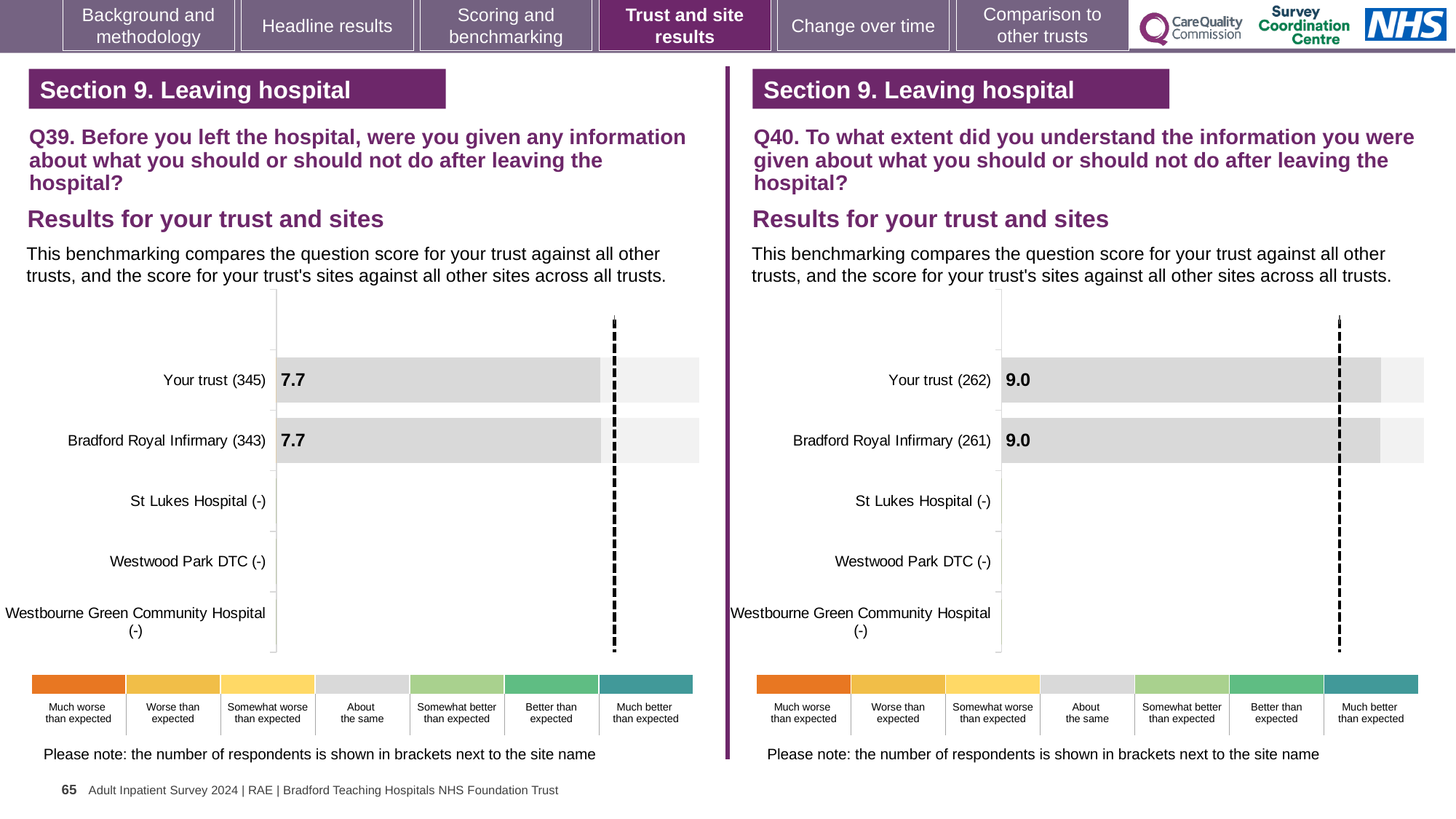
On the Q39 chart (left), what is the score for Your trust? 7.7 On the Q40 chart (right), how many categories have a plotted bar? 2 On the Q40 chart (right), what is the score for Bradford Royal Infirmary? 9.0 On the Q39 chart (left), what is the score for Bradford Royal Infirmary? 7.7 On the Q39 chart (left), how many site or trust categories are listed on the vertical axis? 5 On the Q39 chart (left), how many respondents are shown in brackets for Bradford Royal Infirmary? 343 On the Q40 chart (right), how many respondents are shown in brackets for Your trust? 262 On the Q40 chart (right), how many benchmark bands are shown in the colour key below the chart? 7 What kind of chart is used on the Q40 chart (right)? Bar chart On the Q40 chart (right), what is the score for Your trust? 9.0 On the Q39 chart (left), what is the difference between the score for Your trust and the score for Bradford Royal Infirmary? 0.0 On the Q39 chart (left), which category is listed last on the vertical axis? Westbourne Green Community Hospital (-)